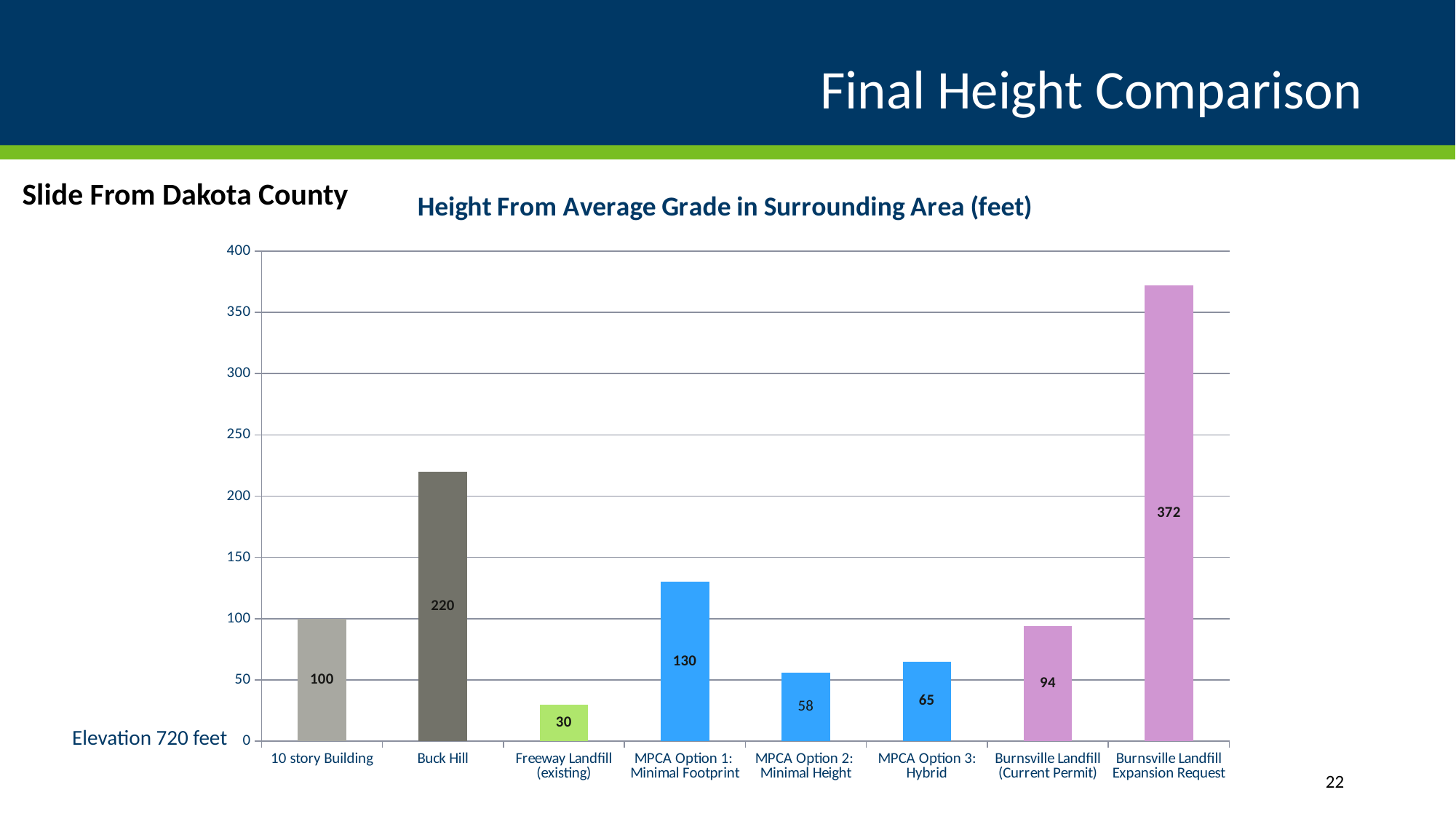
Which category has the lowest value? Freeway Landfill (existing) What is the value for Freeway Landfill (existing)? 30 Which is larger, the value for MPCA Option 2: Minimal Height or MPCA Option 3: Hybrid? MPCA Option 3: Hybrid What is the value for Buck Hill? 220 What kind of chart is shown on the slide? Bar chart What is the title of the chart? Height From Average Grade in Surrounding Area (feet) What is the value for Burnsville Landfill (Current Permit)? 94 Is the value for Buck Hill greater or less than 200? greater How many categories are shown on the x axis? 8 What is the value for MPCA Option 1: Minimal Footprint? 130 What is the difference between the values for Burnsville Landfill Expansion Request and Burnsville Landfill (Current Permit)? 278 Which category has the highest value? Burnsville Landfill Expansion Request